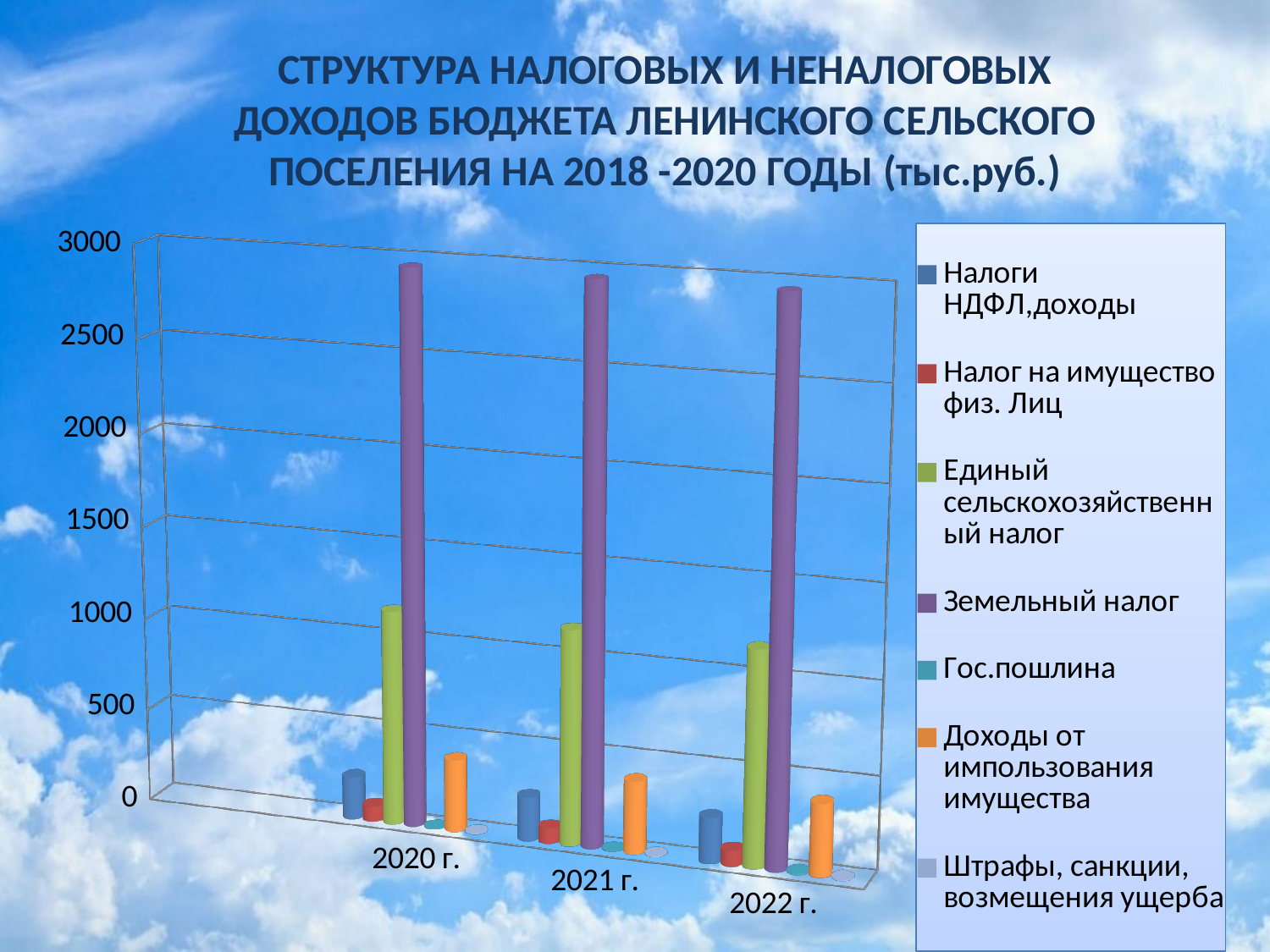
How many year categories are shown on the x axis of the chart? 3 Is the value of Доходы от импользования имущества for 2020 г. greater or less than 500? less Which series has the highest value in 2020 г.? Земельный налог Is the value of Единый сельскохозяйственный налог for 2022 г. greater or less than 500? greater Is the value of Земельный налог for 2022 г. greater or less than 2000? greater Which colour represents Земельный налог in the chart legend? purple Which is larger in 2021 г.: Земельный налог or Единый сельскохозяйственный налог? Земельный налог How many series does the chart legend list? 7 What kind of chart is shown on the slide? bar chart